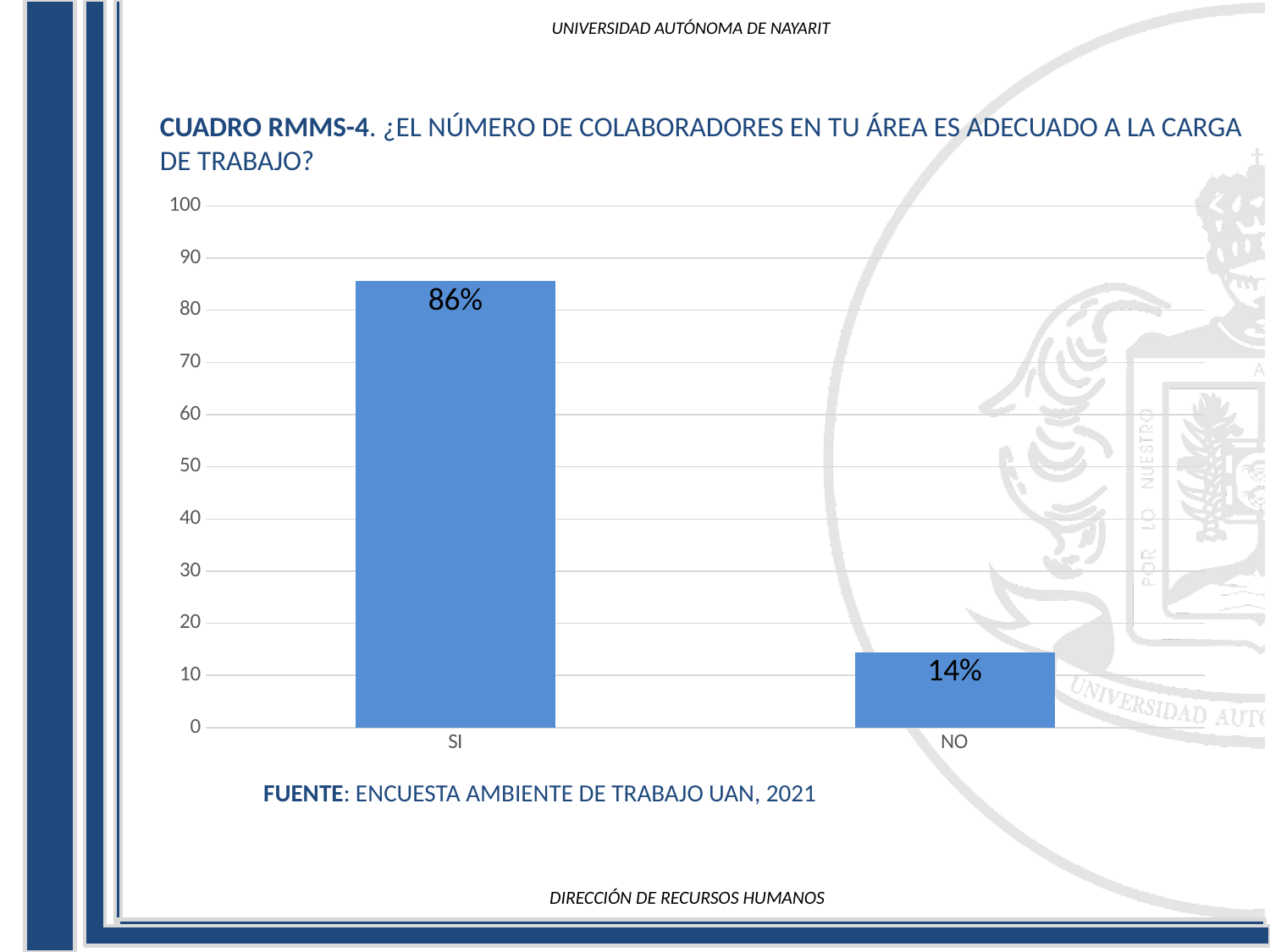
Which category has the lowest value? NO Is the value for NO greater or less than 20? less What is the difference between the values for SI and NO? 72% What is the source cited below the chart? ENCUESTA AMBIENTE DE TRABAJO UAN, 2021 What is the maximum value shown on the vertical axis? 100 Which category has the highest value? SI What is the value for NO? 14% What is the value for SI? 86% How many categories are shown on the x axis? 2 Is the value for SI greater or less than 80? greater Which is larger, the value for SI or the value for NO? SI What kind of chart is shown on the slide? bar chart